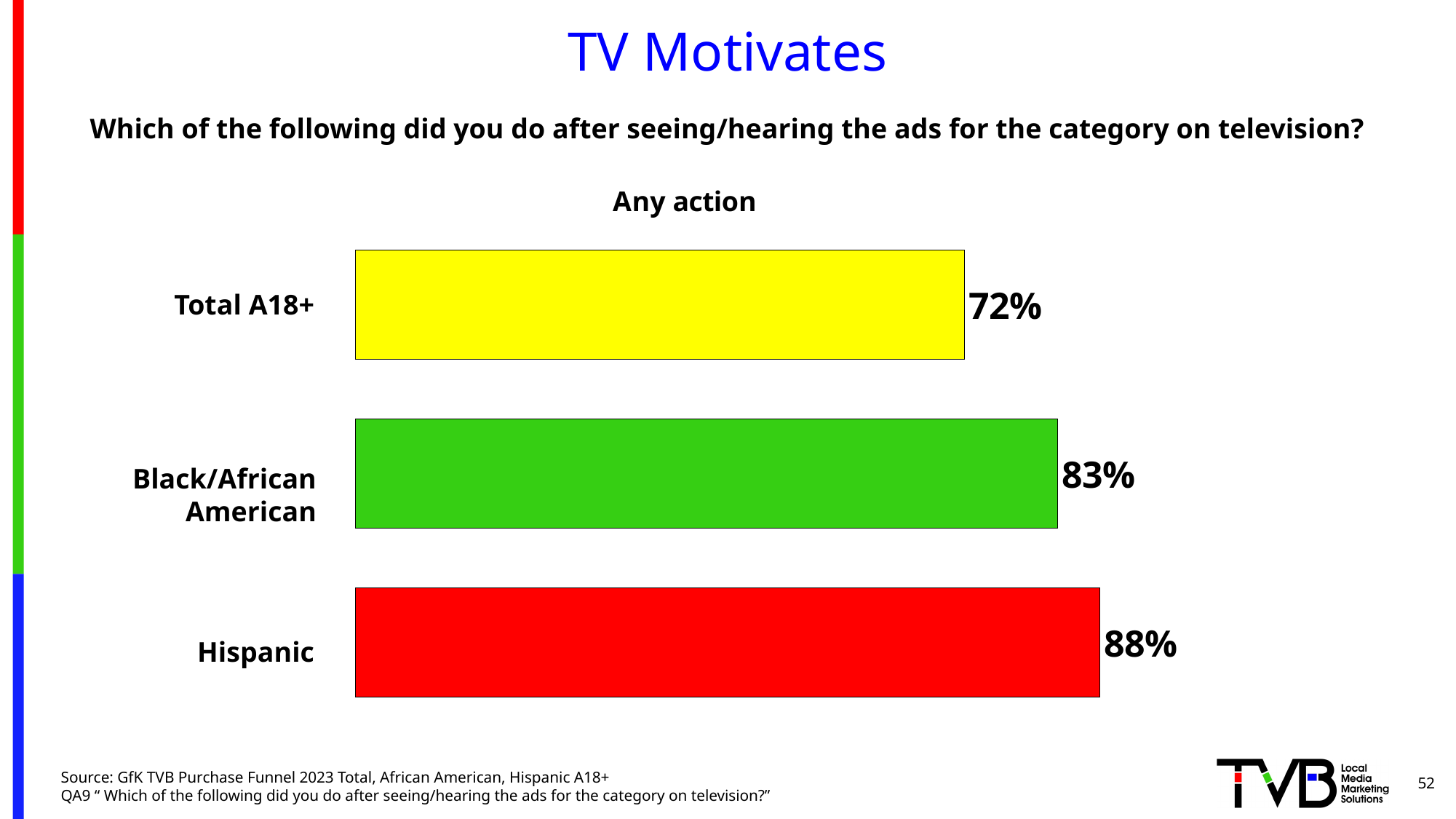
How many categories are shown in the chart? 3 Which is larger, the value for Black/African American or the value for Hispanic? Hispanic What colour is the bar for Hispanic? Red What is the difference between the Hispanic value and the Total A18+ value? 16% What is the value for Hispanic? 88% Which category has the highest value? Hispanic What is the difference between the Black/African American value and the Total A18+ value? 11% What is the value for Total A18+? 72% Which category has the lowest value? Total A18+ What is the value for Black/African American? 83% What kind of chart is shown on the slide? Bar chart What is the title of the chart? Any action